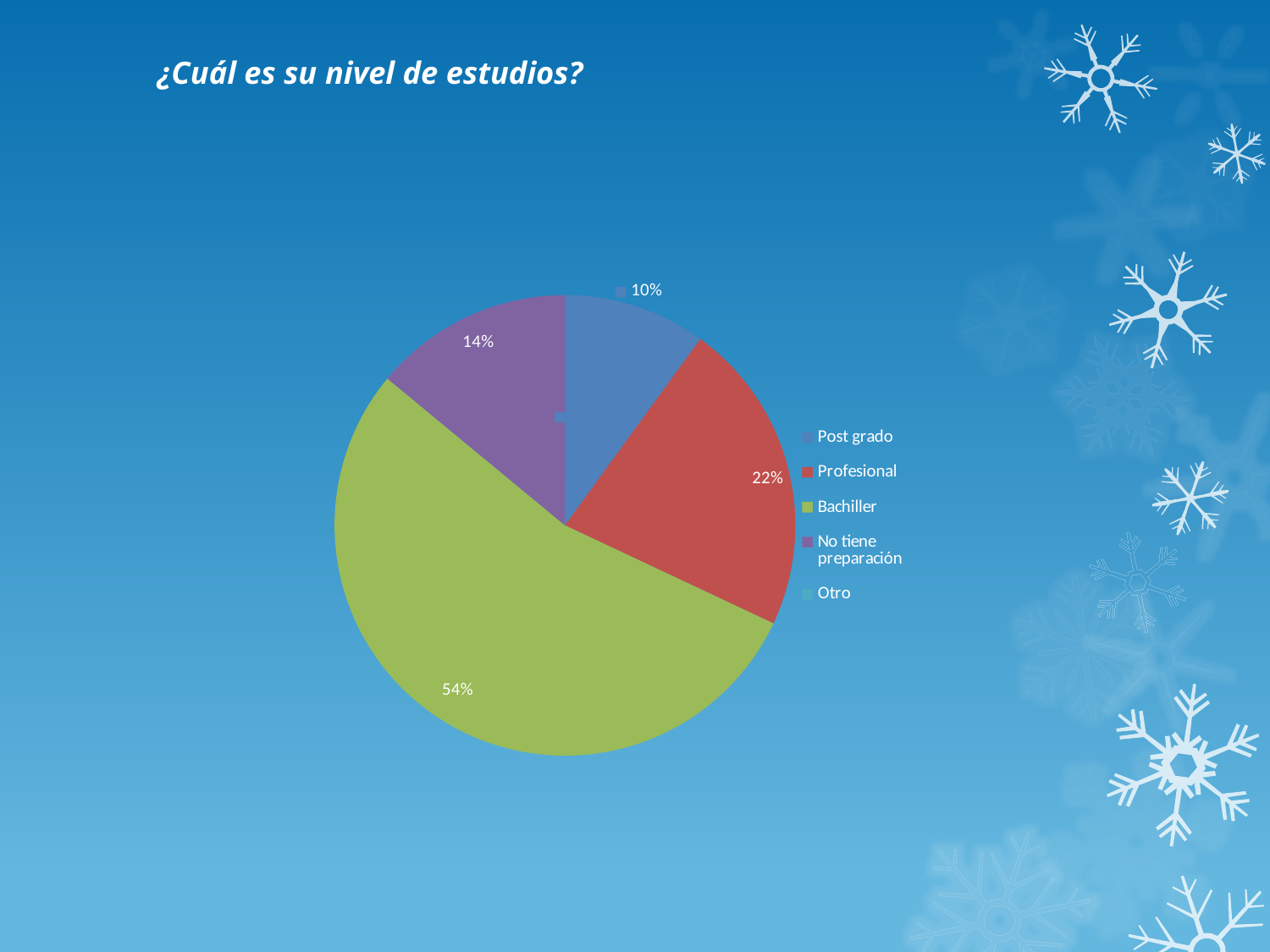
Which is larger, Profesional or No tiene preparación? Profesional Which of the labeled slices is the smallest? Post grado Which category has the largest slice of the pie? Bachiller What is the value shown for No tiene preparación? 14% What is the value shown for Profesional? 22% How many categories does the legend list? 5 What is the difference in percentage points between Bachiller and Profesional? 32 What is the value shown for Post grado? 10% What type of chart is shown on the slide? pie chart What percentage of the pie does Bachiller represent? 54% What is the difference in percentage points between No tiene preparación and Post grado? 4 What is the title of the chart? ¿Cuál es su nivel de estudios?